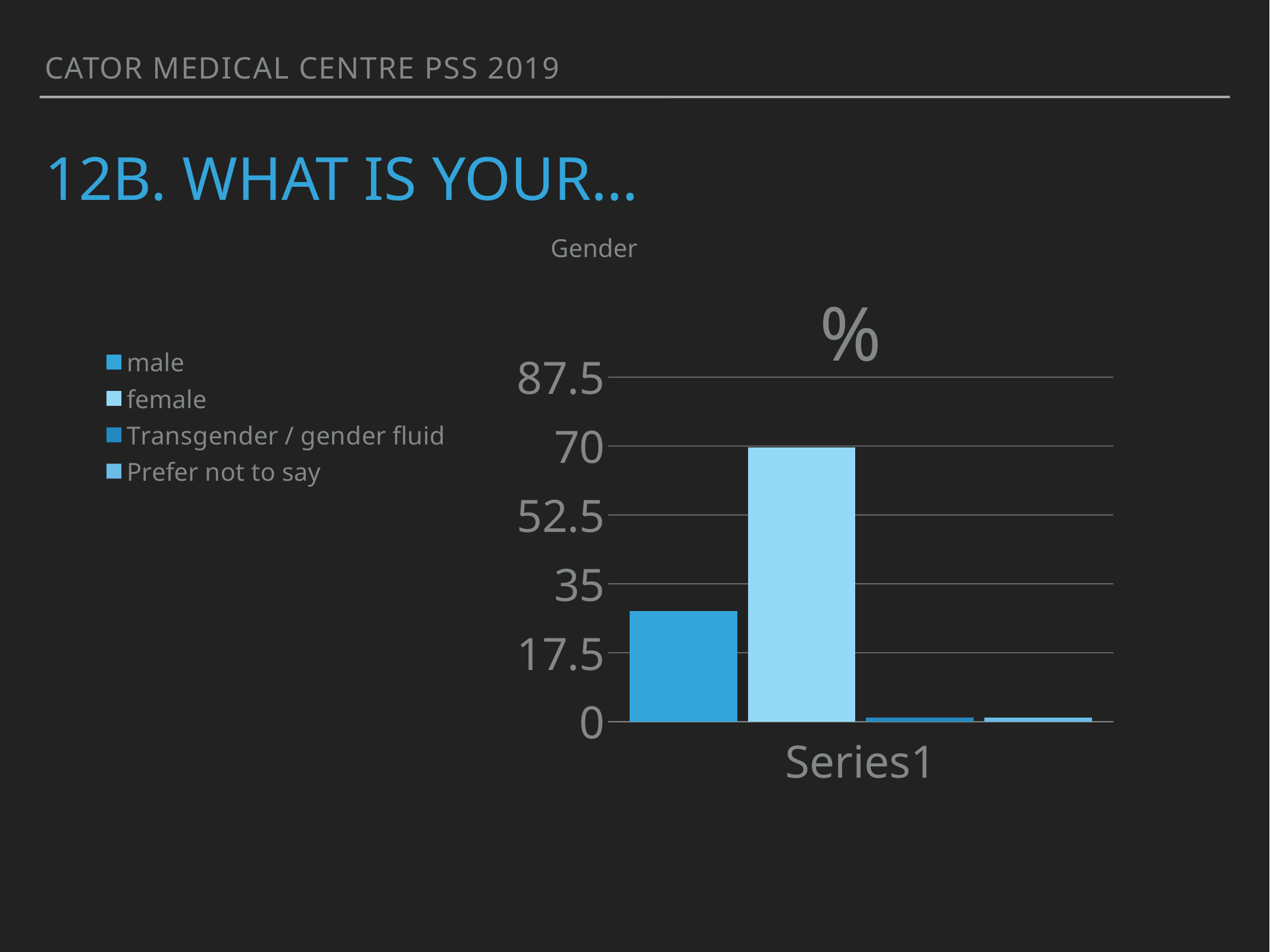
Which legend category has the highest bar? female Is the value for Prefer not to say greater or less than 17.5? less What is the title of the chart? % Is the value for male greater or less than 35? less Is the value for Transgender / gender fluid greater or less than 17.5? less How many entries does the chart's legend list? 4 Which is larger, the value for male or the value for female? female What kind of chart is shown on the slide? bar chart Which is larger, the value for male or the value for Prefer not to say? male